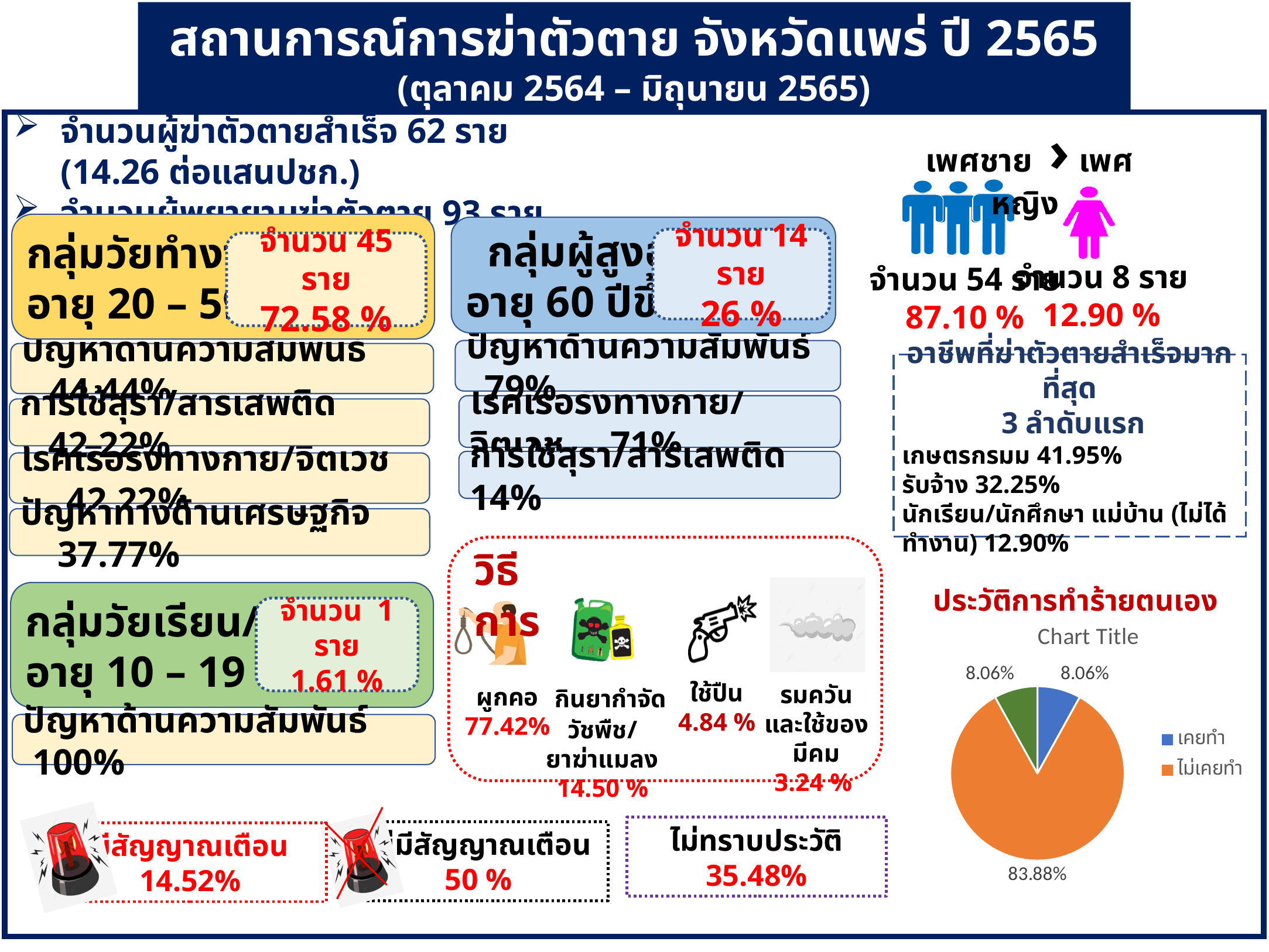
How many slices does the pie chart have? 3 In the pie chart, what percentage is shown for ไม่เคยทำ? 83.88% What colour is the ไม่เคยทำ slice in the pie chart? orange How many entries does the legend of the pie chart list? 2 What kind of chart is shown under the heading ประวัติการทำร้ายตนเอง? pie chart What title is printed directly above the pie chart? Chart Title In the pie chart, what percentage is shown for เคยทำ? 8.06% Which legend category has the largest slice in the pie chart? ไม่เคยทำ In the pie chart, which is larger: เคยทำ or ไม่เคยทำ? ไม่เคยทำ In the pie chart, what is the difference between the ไม่เคยทำ slice and the เคยทำ slice? 75.82%